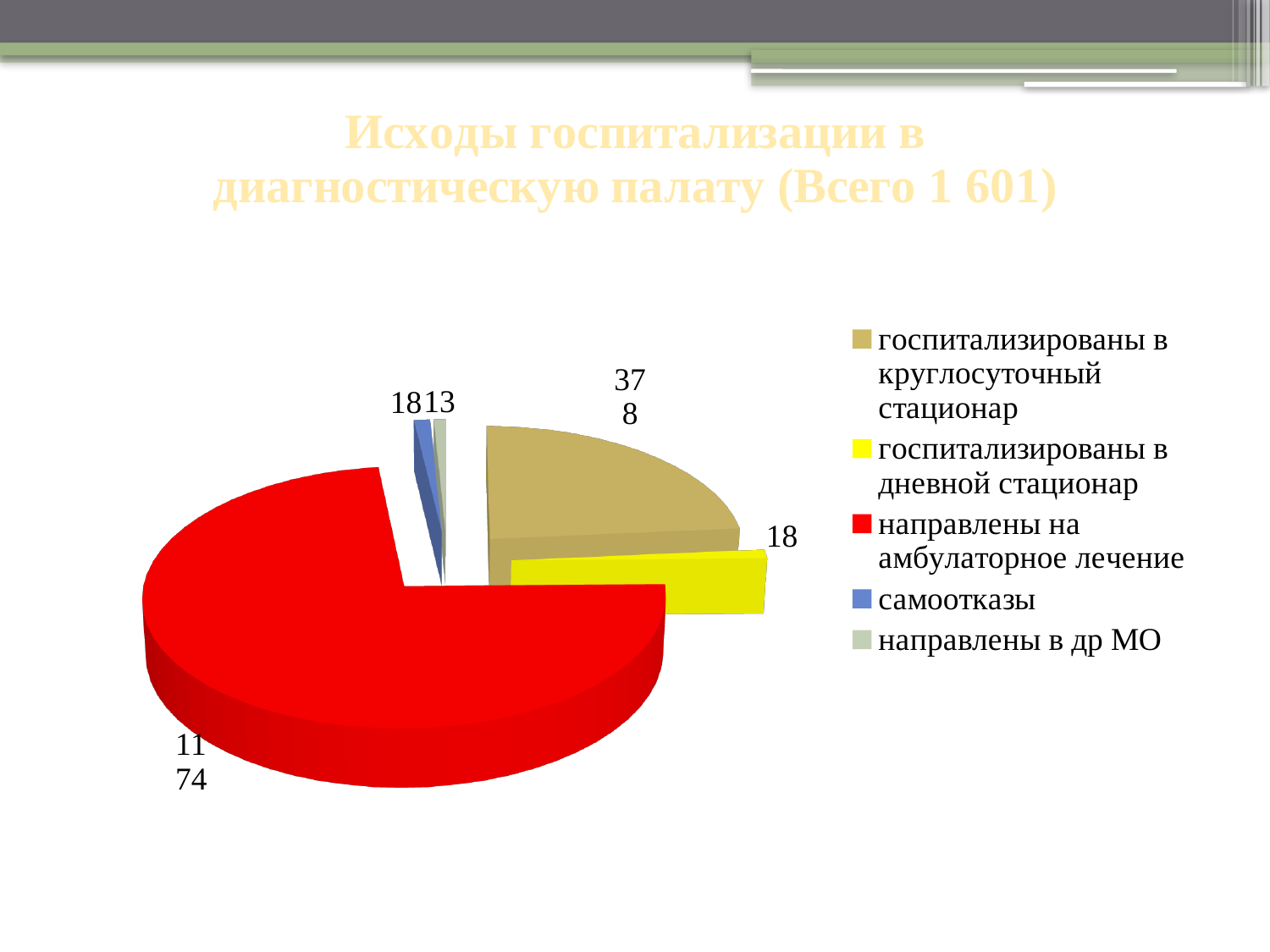
What is the difference between the value for "самоотказы" and the value for "направлены в др МО"? 5 What is the value for "госпитализированы в круглосуточный стационар"? 378 What is the value for "самоотказы"? 18 Which category has the smallest slice of the pie? направлены в др МО What total is given in the chart title? 1 601 Which category has the largest slice of the pie? направлены на амбулаторное лечение What is the value for "направлены в др МО"? 13 How many slices does the pie chart have? 5 What kind of chart is shown on the slide? pie chart What is the value for "госпитализированы в дневной стационар"? 18 Which is larger, the value for "самоотказы" or the value for "направлены в др МО"? самоотказы How many entries does the legend list? 5